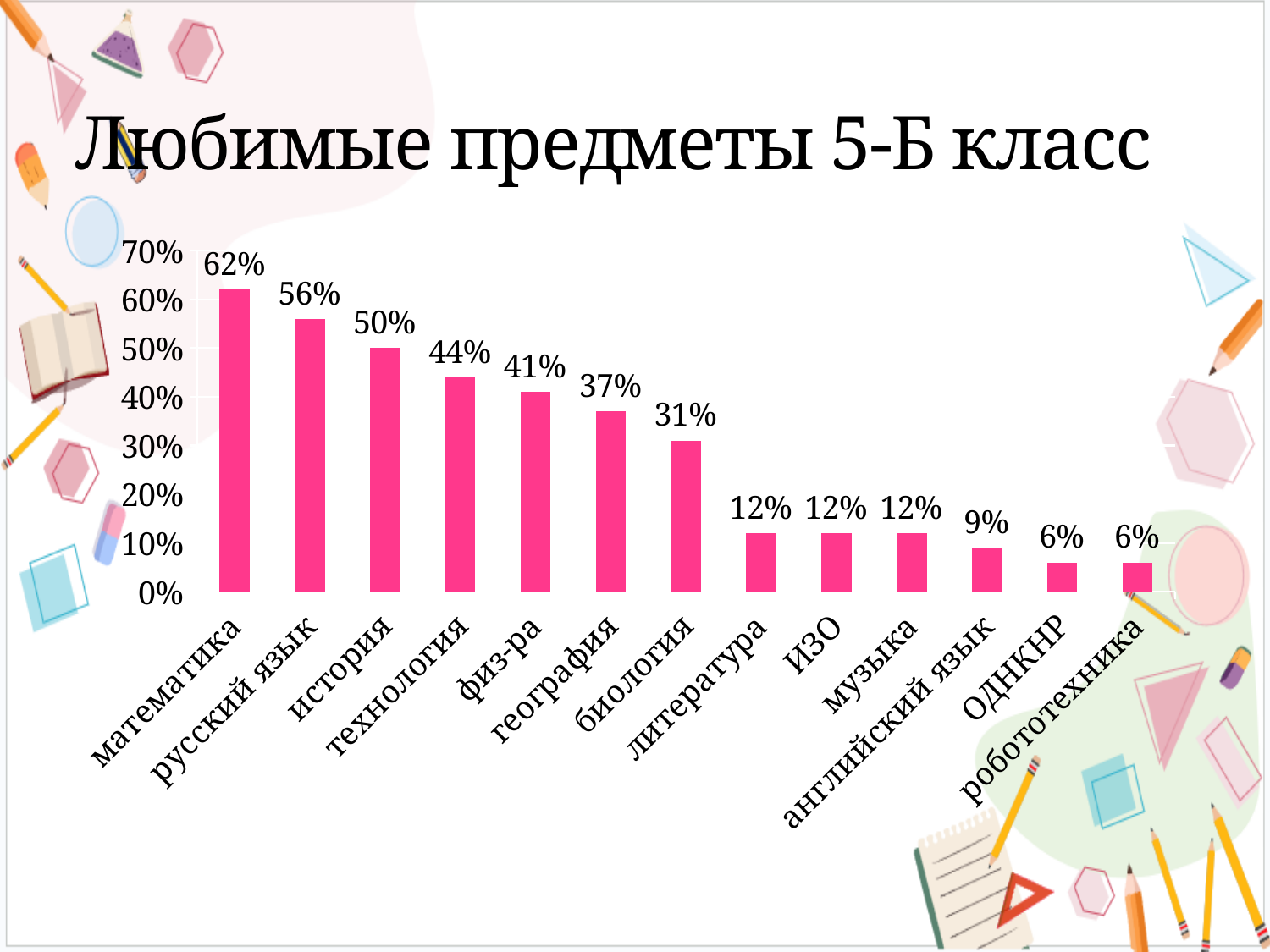
What is the value for география? 37% What is the difference between the values for русский язык and история? 6% Is the value for биология greater or less than 40%? less Which subject has the highest value? математика What is the value for английский язык? 9% Which is larger, the value for технология or the value for физ-ра? технология Do the values rise or fall from left to right along the x axis? fall What is the difference between the values for математика and биология? 31% How many subjects are shown on the chart? 13 What is the value for математика? 62% What kind of chart is shown on the slide? bar chart What is the lowest value shown on the chart? 6%